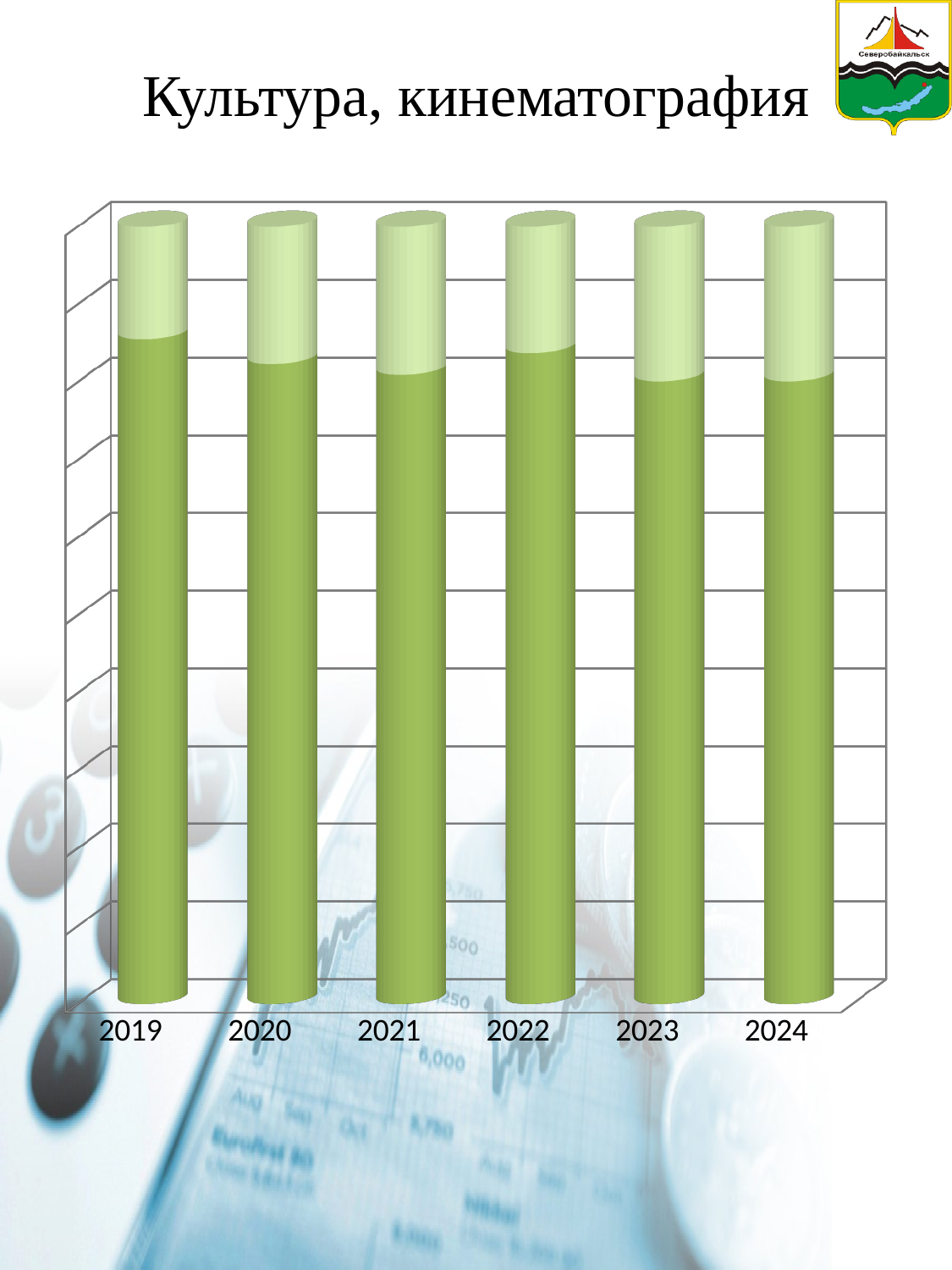
Which year has the tallest dark green segment? 2019 What kind of chart is shown on the slide? bar chart Is the dark green segment larger for 2019 or for 2021? 2019 Which year has the smallest light green segment at the top of its bar? 2019 Which year is the first category on the x axis? 2019 Is the dark green segment larger for 2019 or for 2024? 2019 Which year has the largest light green segment at the top of its bar? 2023 and 2024 (tie) What is the title of the slide with the chart? Культура, кинематография How many years are shown on the x axis of the chart? 6 Is the dark green segment larger for 2022 or for 2024? 2022